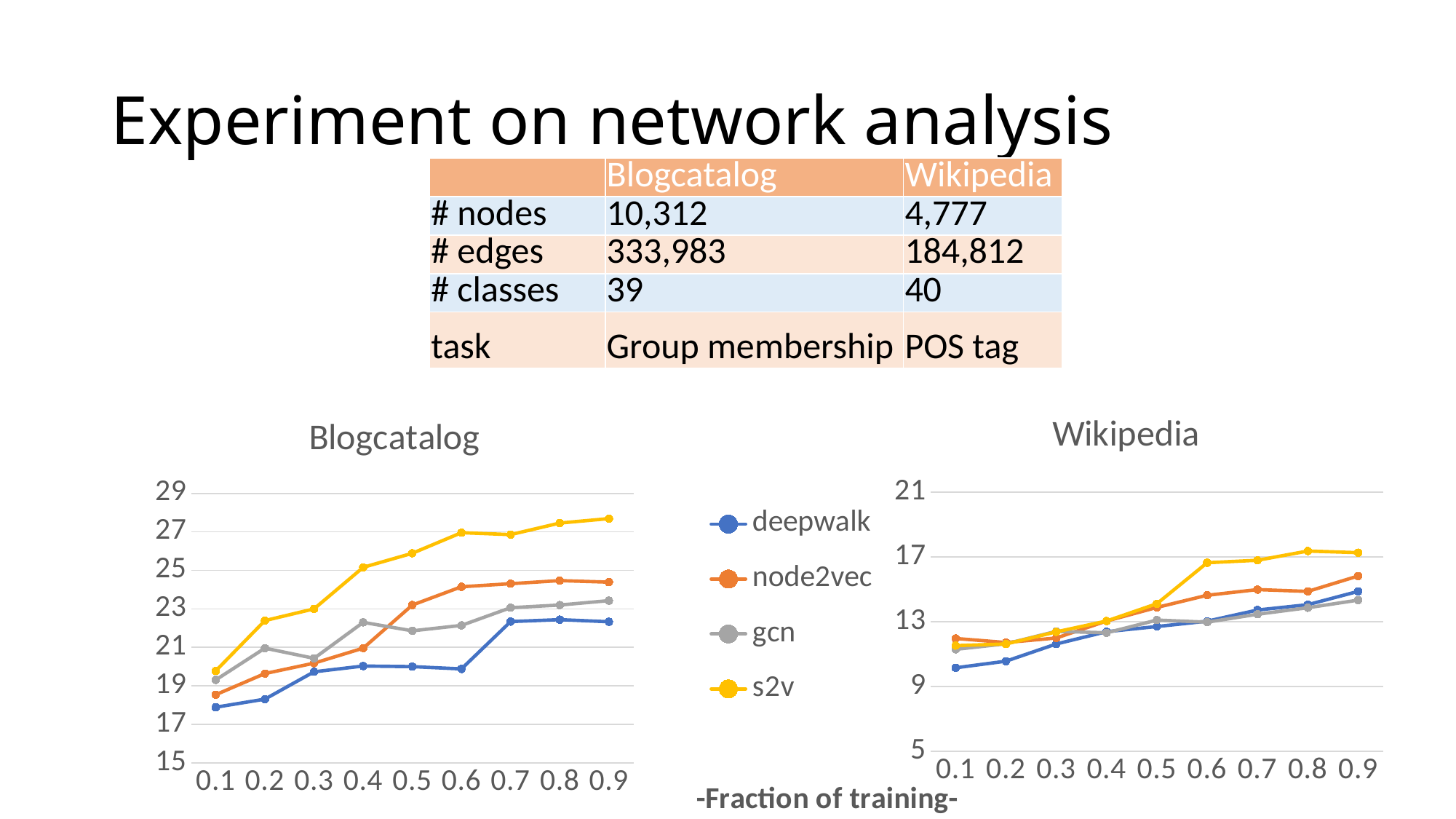
In the Wikipedia chart, is the value for node2vec at 0.9 greater or less than 13? greater How many x-axis points does the Wikipedia chart have? 9 In the Wikipedia chart, which series is lowest at 0.1? deepwalk In the Wikipedia chart, does the s2v series generally rise or fall as the fraction of training increases? rise In the Wikipedia chart, which series is highest at 0.9? s2v In the Blogcatalog chart, which is larger at 0.4: s2v or deepwalk? s2v In the Blogcatalog chart, is the value for deepwalk at 0.1 greater or less than 19? less In the Blogcatalog chart, is the value for s2v at 0.9 greater or less than 27? greater In the Blogcatalog chart, which series is lowest at 0.9? deepwalk In the Blogcatalog chart, which series is highest at 0.9? s2v How many series does the legend list? 4 What kind of chart is the Blogcatalog chart? line chart